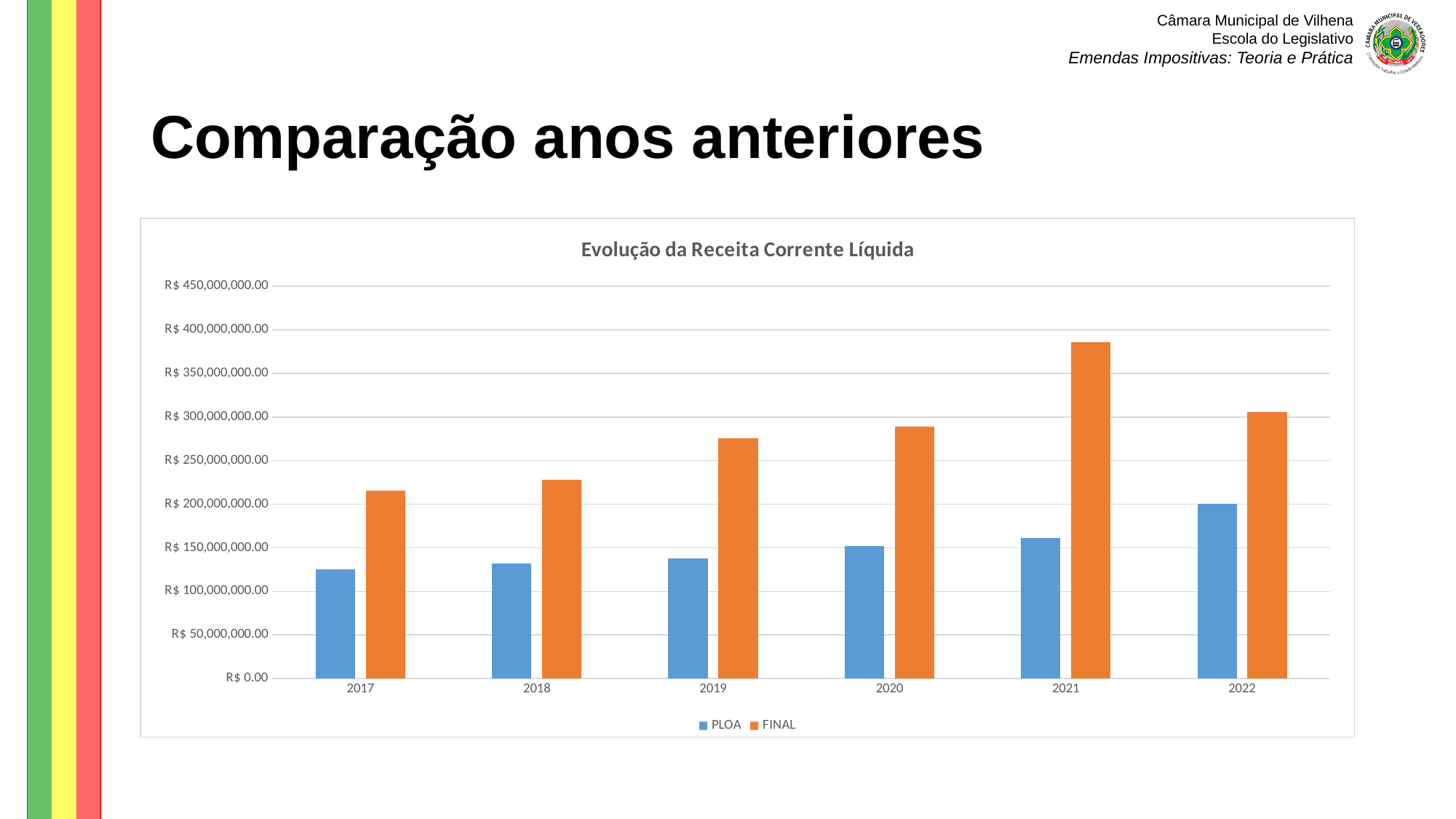
How many series does the legend list? 2 In which year is the PLOA value lowest? 2017 In which year is the PLOA value highest? 2022 What is the title of the chart? Evolução da Receita Corrente Líquida Is the FINAL value for 2019 greater or less than R$ 250,000,000.00? greater What kind of chart is shown on the slide? bar chart Is the PLOA value for 2017 greater or less than R$ 150,000,000.00? less Which is larger, the FINAL value for 2021 or the FINAL value for 2022? 2021 Do the PLOA values rise or fall from 2017 to 2022? rise In which year is the FINAL value highest? 2021 How many years are shown on the x axis? 6 Is the FINAL value for 2021 greater or less than R$ 350,000,000.00? greater